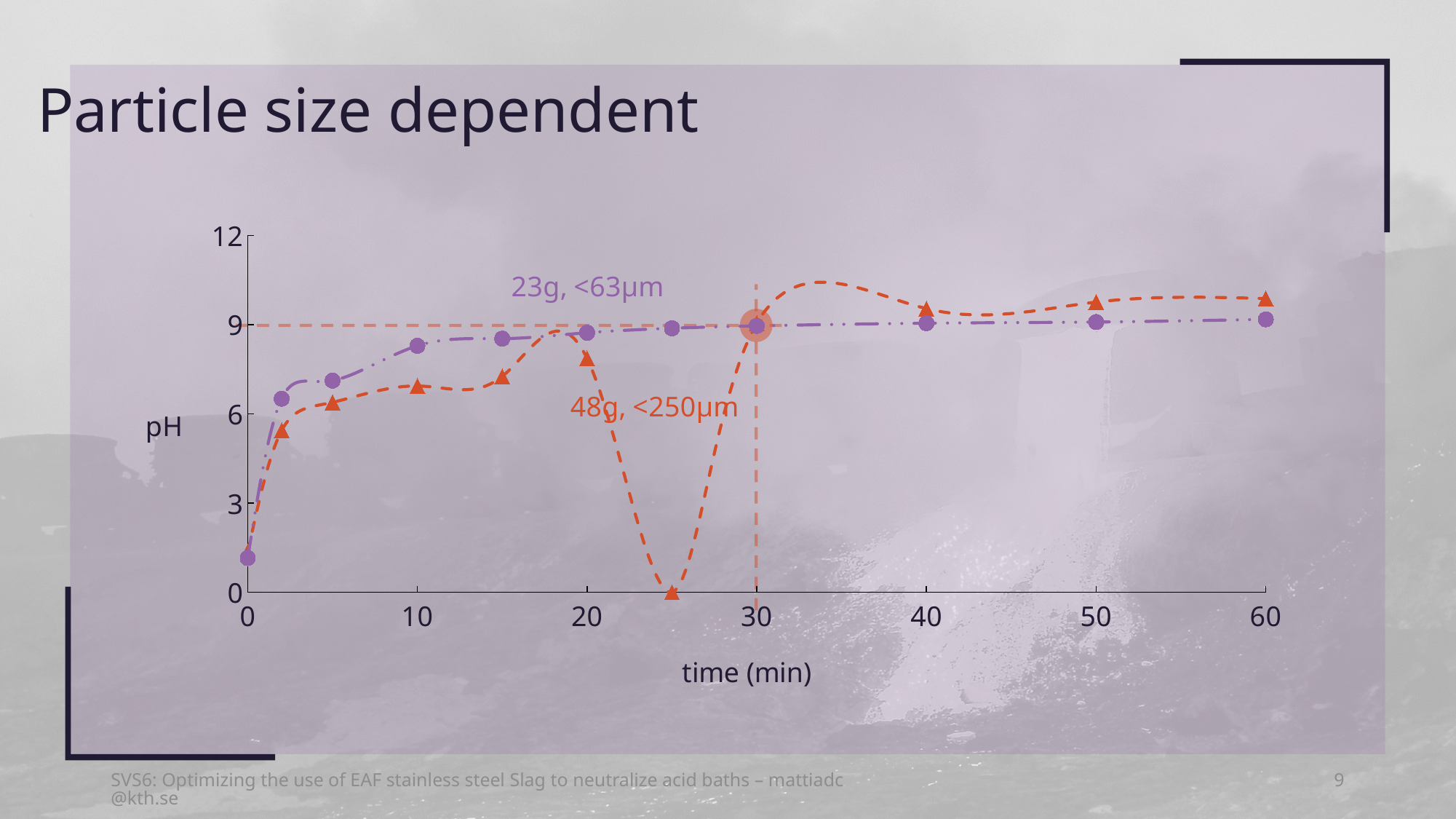
What is the label of the x axis of the chart? time (min) How many data series are plotted in the chart? 2 Is the pH of the 48g, <250μm series at 20 min greater or less than 9? less What kind of chart is shown on the slide? line chart Is the pH of the 23g, <63μm series at 0 min greater or less than 3? less What is the pH value of the 48g, <250μm series at 25 min? 0 At 25 min, which series has the higher pH, 23g, <63μm or 48g, <250μm? 23g, <63μm Does the pH of the 23g, <63μm series generally rise or fall as time increases? rise At which time does the 23g, <63μm series have its lowest pH? 0 min At which time does the 48g, <250μm series reach its lowest pH? 25 min Is the pH of the 48g, <250μm series at 50 min greater or less than 9? greater What is the label of the y axis of the chart? pH